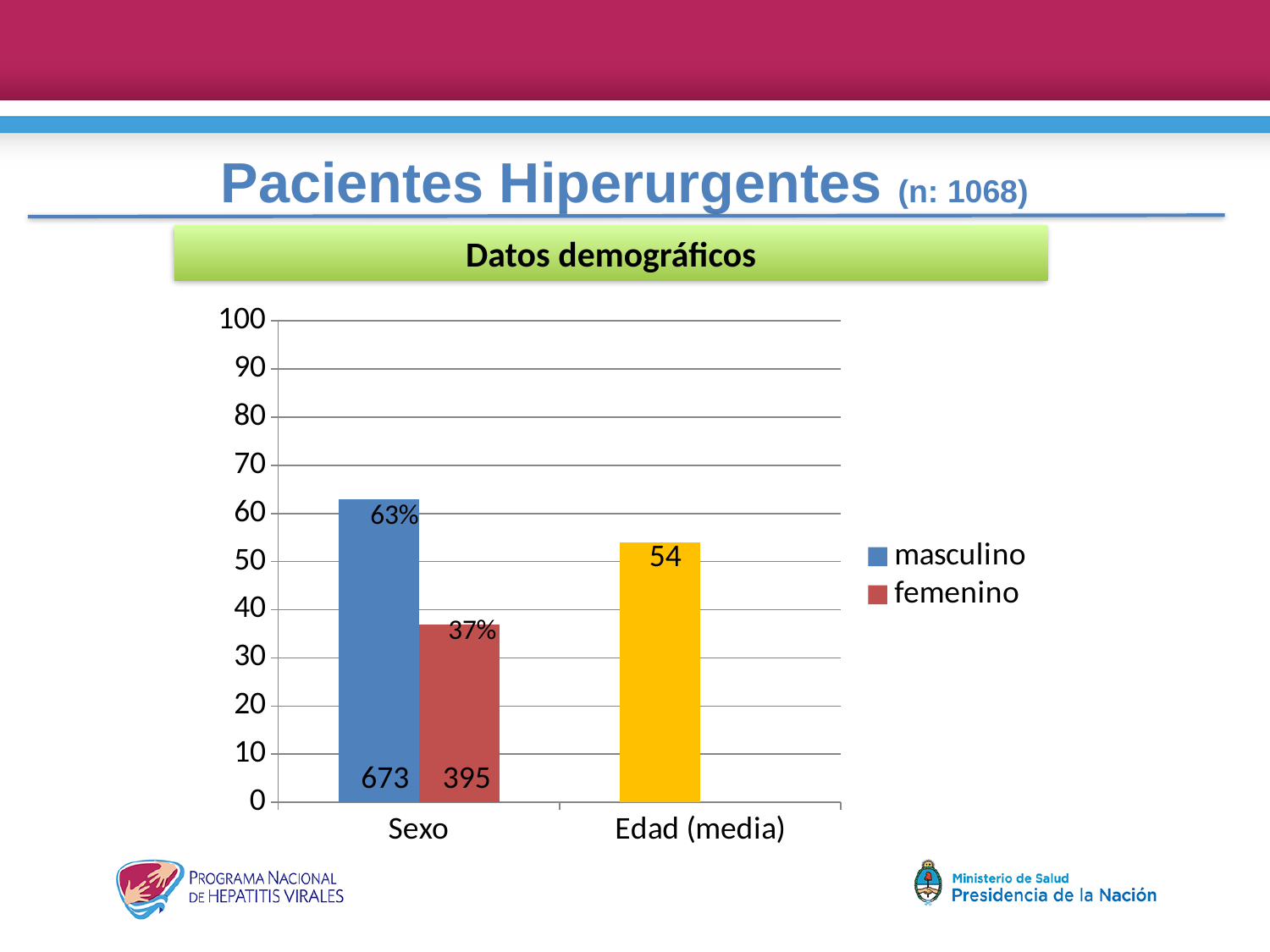
Which is larger in the Sexo category, masculino or femenino? masculino What count is printed at the base of the masculino bar? 673 What value is shown for Edad (media)? 54 What is the difference between the masculino count (673) and the femenino count (395)? 278 What is the sample size (n) given in the slide title? 1068 What is the difference in percentage points between masculino (63%) and femenino (37%)? 26 What percentage is shown for femenino in the Sexo category? 37% What percentage is shown for masculino in the Sexo category? 63% Is the value for Edad (media) greater or less than 50? greater What kind of chart is shown on the slide? bar chart How many series does the legend list? 2 What count is printed at the base of the femenino bar? 395